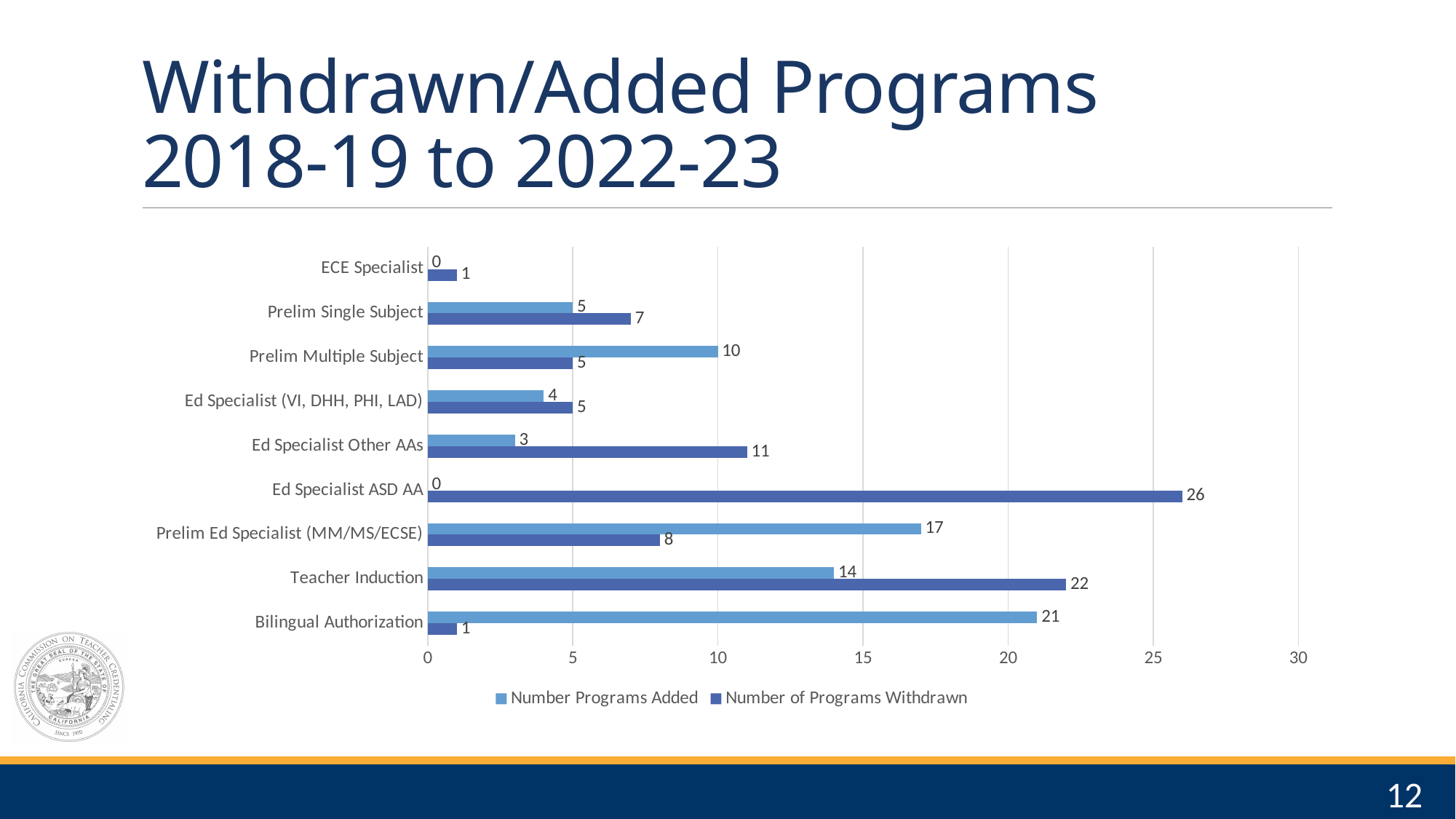
What is the difference between programs withdrawn and programs added for Teacher Induction? 8 How many programs were withdrawn for Teacher Induction? 22 What is the total of programs added and withdrawn for Ed Specialist Other AAs? 14 How many categories are shown on the chart? 9 How many programs were withdrawn for Ed Specialist ASD AA? 26 How many programs were added for Prelim Ed Specialist (MM/MS/ECSE)? 17 Which category has the highest number of programs added? Bilingual Authorization For Prelim Multiple Subject, which is larger: the number of programs added or the number withdrawn? Number Programs Added What kind of chart is shown on the slide? Bar chart How many series does the legend list? 2 Which category has the highest number of programs withdrawn? Ed Specialist ASD AA How many programs were added for Bilingual Authorization? 21